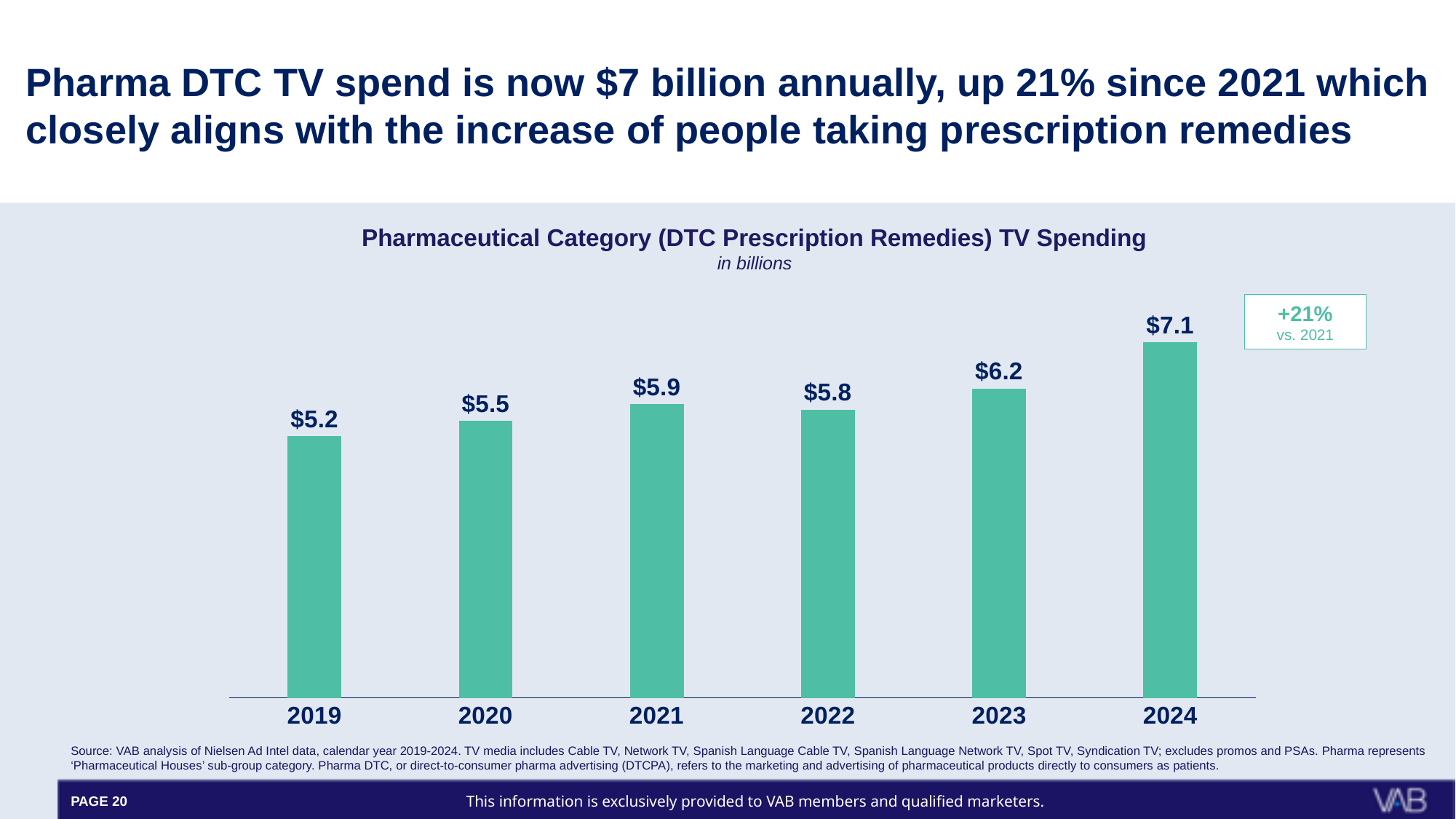
What is the difference in TV spending between 2024 and 2021? $1.2 What was the pharmaceutical category TV spending in 2022? $5.8 Which year has the lowest TV spending on the chart? 2019 What kind of chart is shown on the slide? Bar chart What is the difference in TV spending between 2023 and 2022? $0.4 What was the pharmaceutical category TV spending in 2024? $7.1 How many years are shown on the chart? 6 Which year had higher TV spending, 2021 or 2022? 2021 Which year has the highest TV spending on the chart? 2024 What was the pharmaceutical category TV spending in 2019? $5.2 Did TV spending rise or fall from 2019 to 2021? Rise What percentage change vs. 2021 is called out in the box on the chart? +21%